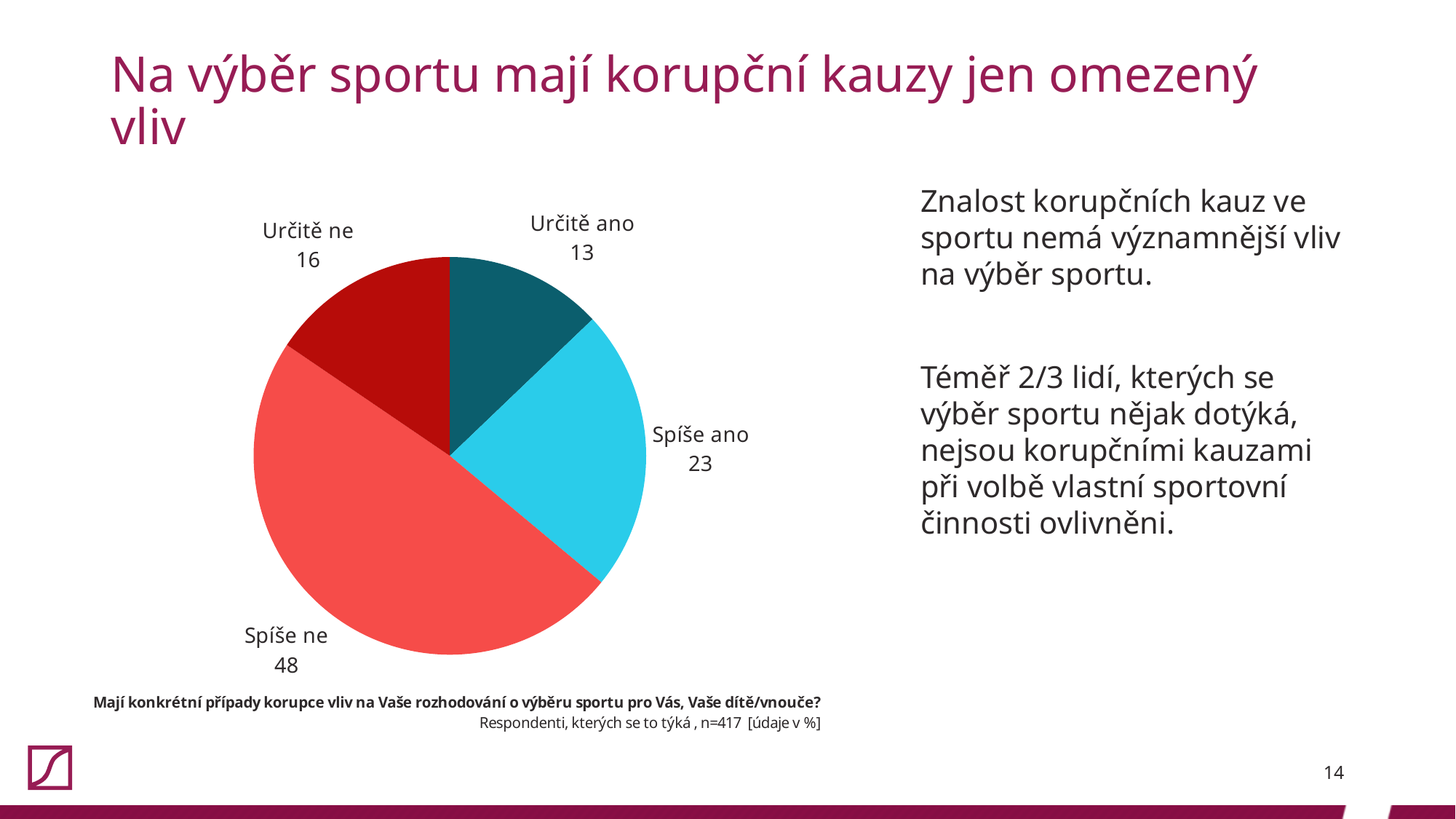
How many slices does the pie chart have? 4 Which is larger, "Určitě ne" or "Určitě ano"? Určitě ne What is the value for "Spíše ano"? 23 What is the value for "Určitě ne"? 16 What is the difference between the values for "Spíše ne" and "Spíše ano"? 25 What is the value for "Určitě ano"? 13 What kind of chart is shown on the slide? pie chart What is the combined value of "Určitě ne" and "Spíše ne"? 64 What is the value for "Spíše ne"? 48 Which category has the smallest slice? Určitě ano Which category has the largest slice? Spíše ne What colour is the "Spíše ano" slice? light blue